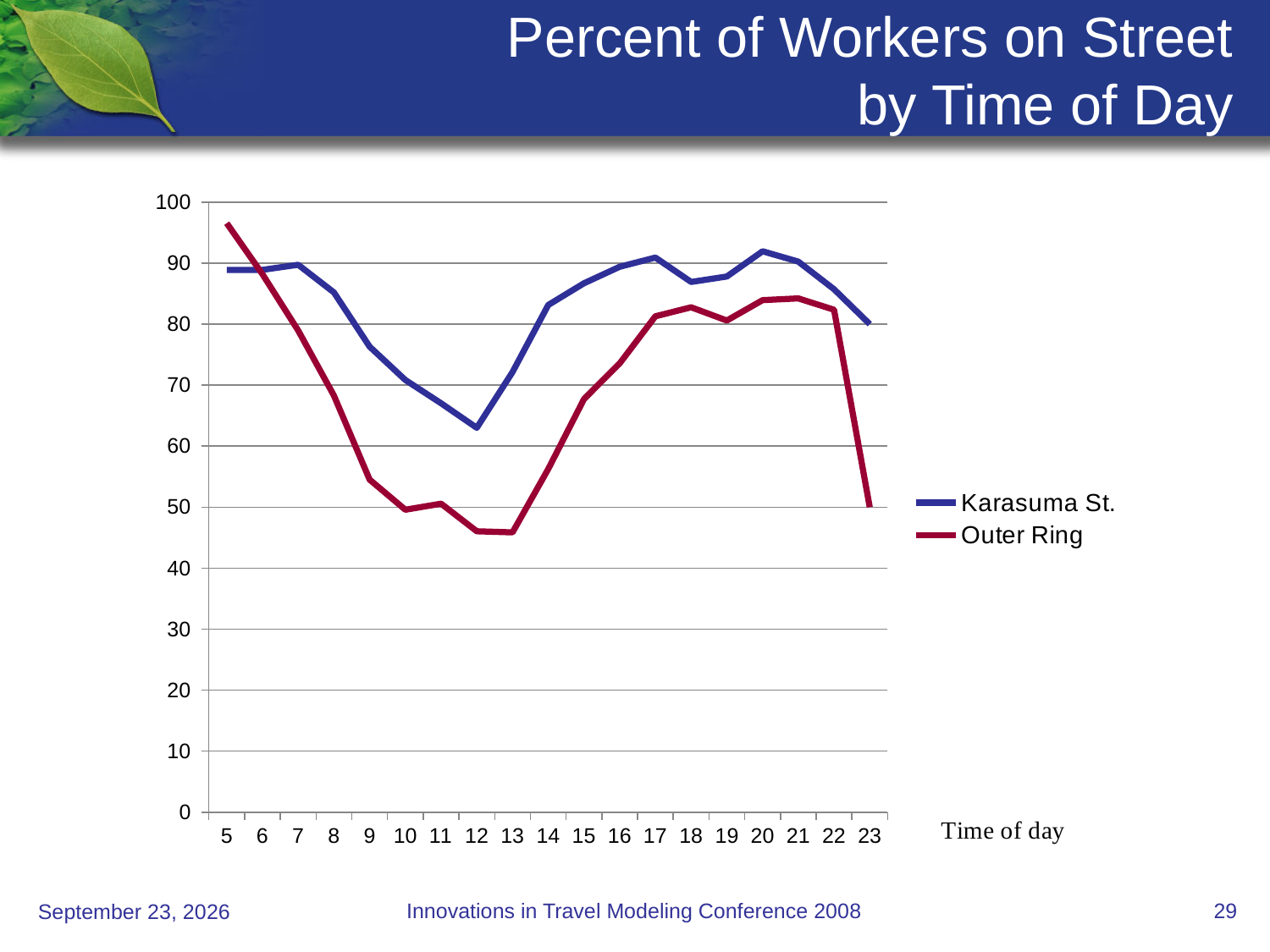
What is the label of the x axis? Time of day How many time-of-day points are plotted along the x axis? 19 At time 5, which series has the larger value, Karasuma St. or Outer Ring? Outer Ring At which time of day is the Outer Ring value highest? 5 Does the Outer Ring series rise or fall from time 5 to time 12? fall At which time of day is the Karasuma St. value lowest? 12 What kind of chart is shown on the slide? line chart Is the Outer Ring value at time 5 greater or less than 90? greater Is the Outer Ring value at time 12 greater or less than 50? less How many series does the legend list? 2 At time 12, which series has the larger value, Karasuma St. or Outer Ring? Karasuma St. Is the Karasuma St. value at time 9 greater or less than 70? greater